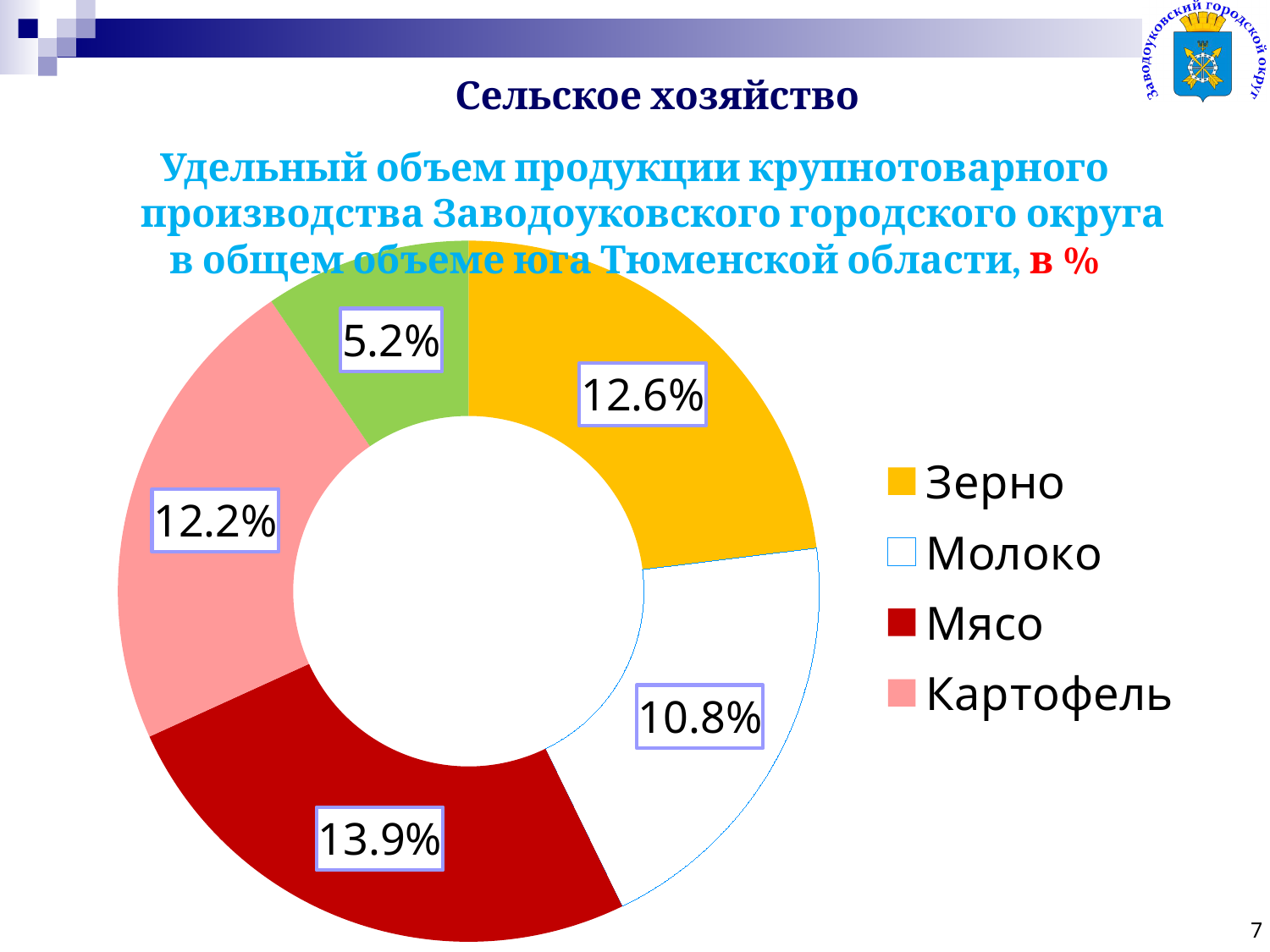
What value is shown for Мясо? 13.9% What value is shown for Картофель? 12.2% How many slices does the chart have? 5 What is the smallest value labelled on the chart? 5.2% What value is shown for Молоко? 10.8% How many entries does the legend list? 4 What colour is the Мясо slice? dark red Which is larger, the value for Зерно or the value for Картофель? Зерно What kind of chart is shown on the slide? doughnut chart What value is shown for Зерно? 12.6% Which legend category has the highest value? Мясо What is the difference between the values for Мясо and Молоко? 3.1%